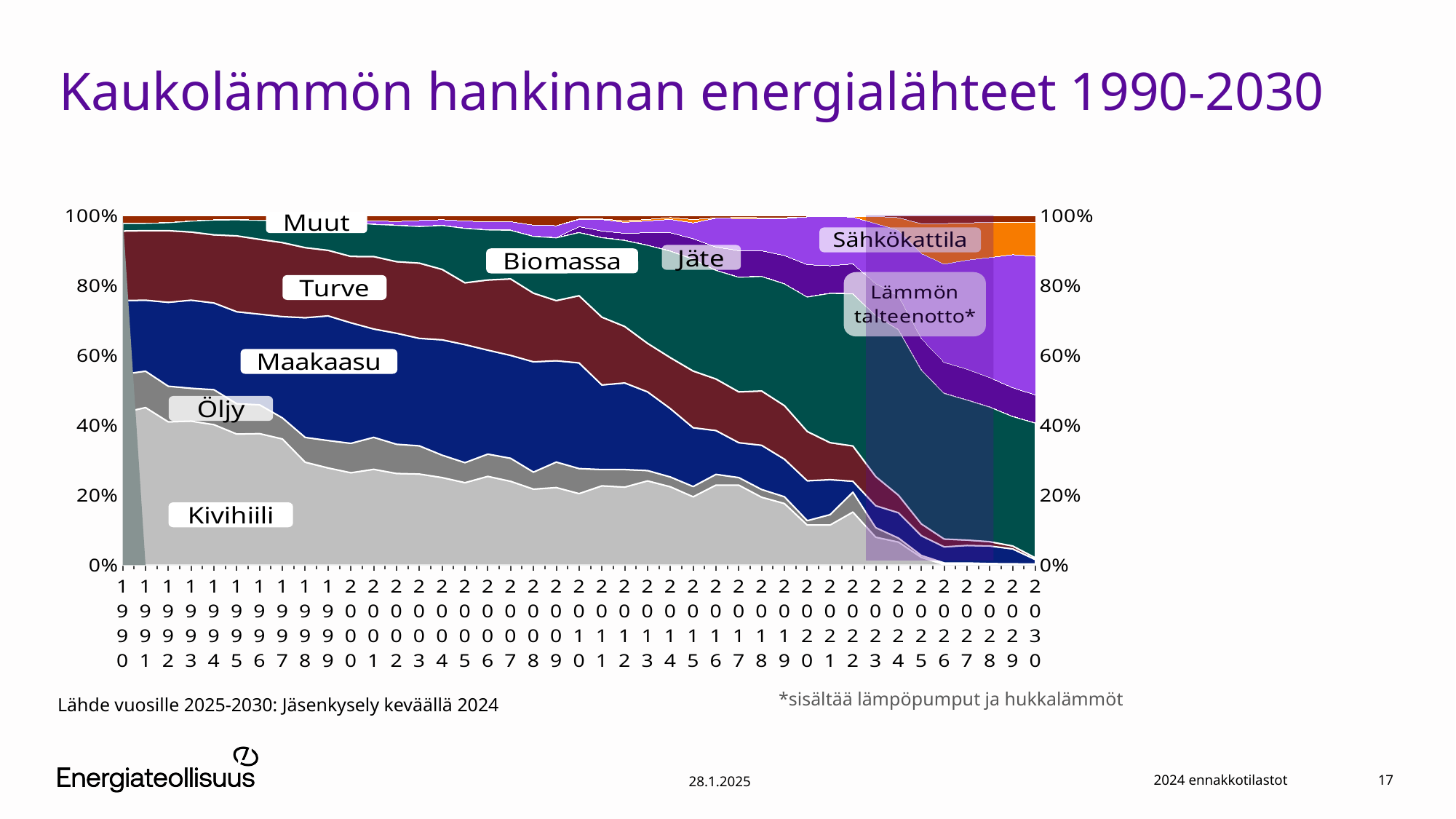
How many years are shown along the x axis of the chart? 41 What is the highest value shown on the y axis of the chart? 100% Does the share of Maakaasu rise or fall from 1990 to 2030? Falls Which energy source has the largest share in 1990? Kivihiili Does the share of Kivihiili rise or fall from 1990 to 2030? Falls How many energy sources are labelled in the chart? 9 Is the share of Kivihiili in 1990 greater or less than 40%? greater Does the share of Biomassa rise or fall from 1990 to 2030? Rises What kind of chart is shown on the slide? Stacked area chart Is the share of Kivihiili in 2030 greater or less than 20%? less What is the title of the chart? Kaukolämmön hankinnan energialähteet 1990-2030